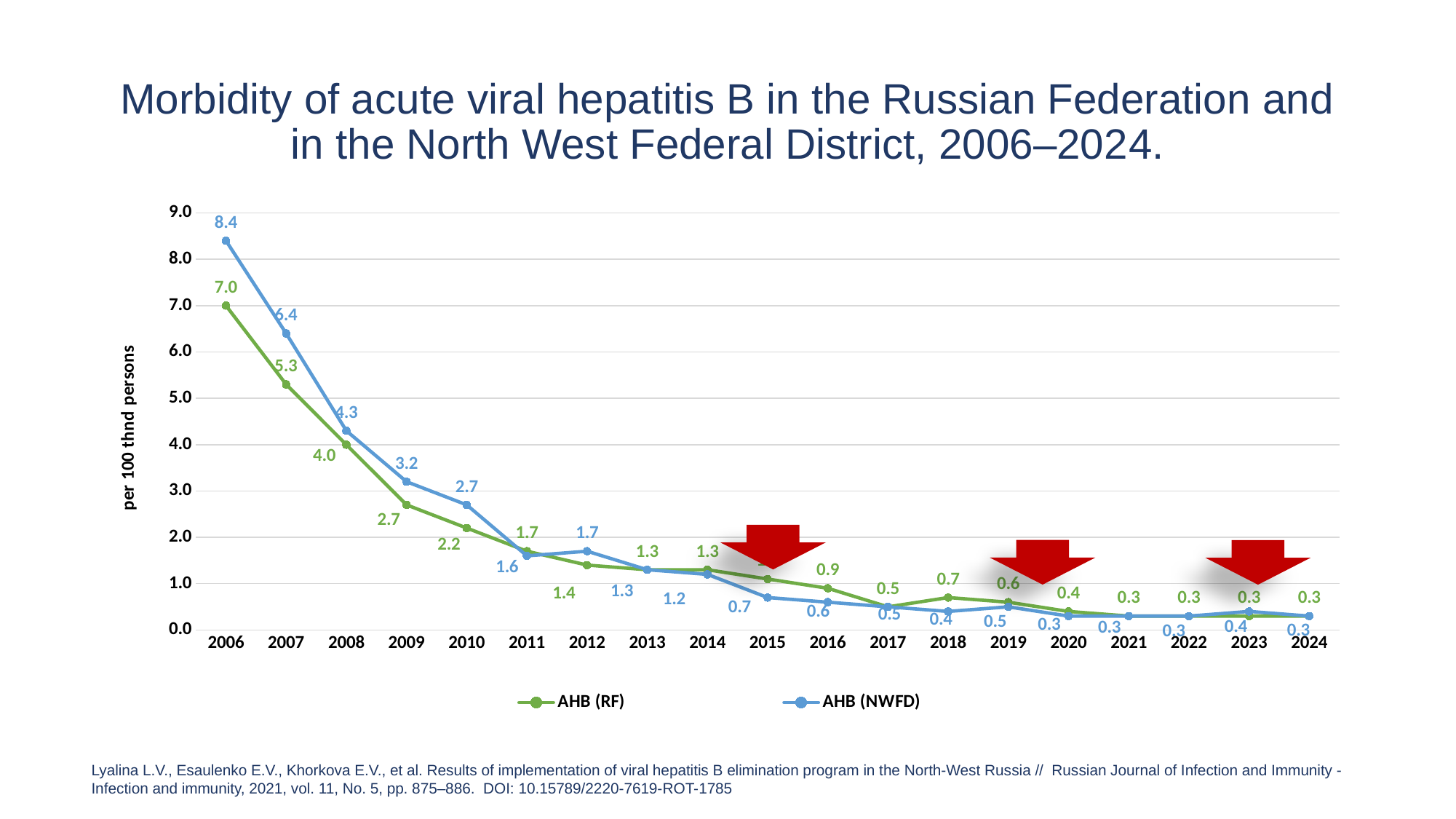
In which year is the AHB (NWFD) value highest? 2006 What is the difference between the AHB (NWFD) and AHB (RF) values in 2006? 1.4 How many years are plotted on the x axis? 19 What kind of chart is shown on the slide? Line chart In 2008, which series has the higher value, AHB (RF) or AHB (NWFD)? AHB (NWFD) What is the value for AHB (RF) in 2006? 7.0 Do the AHB (NWFD) values rise or fall from 2006 to 2024? Fall What is the value for AHB (RF) in 2010? 2.2 What is the value for AHB (NWFD) in 2006? 8.4 How many series does the legend list? 2 What is the value for AHB (NWFD) in 2009? 3.2 What is the value for AHB (RF) in 2018? 0.7